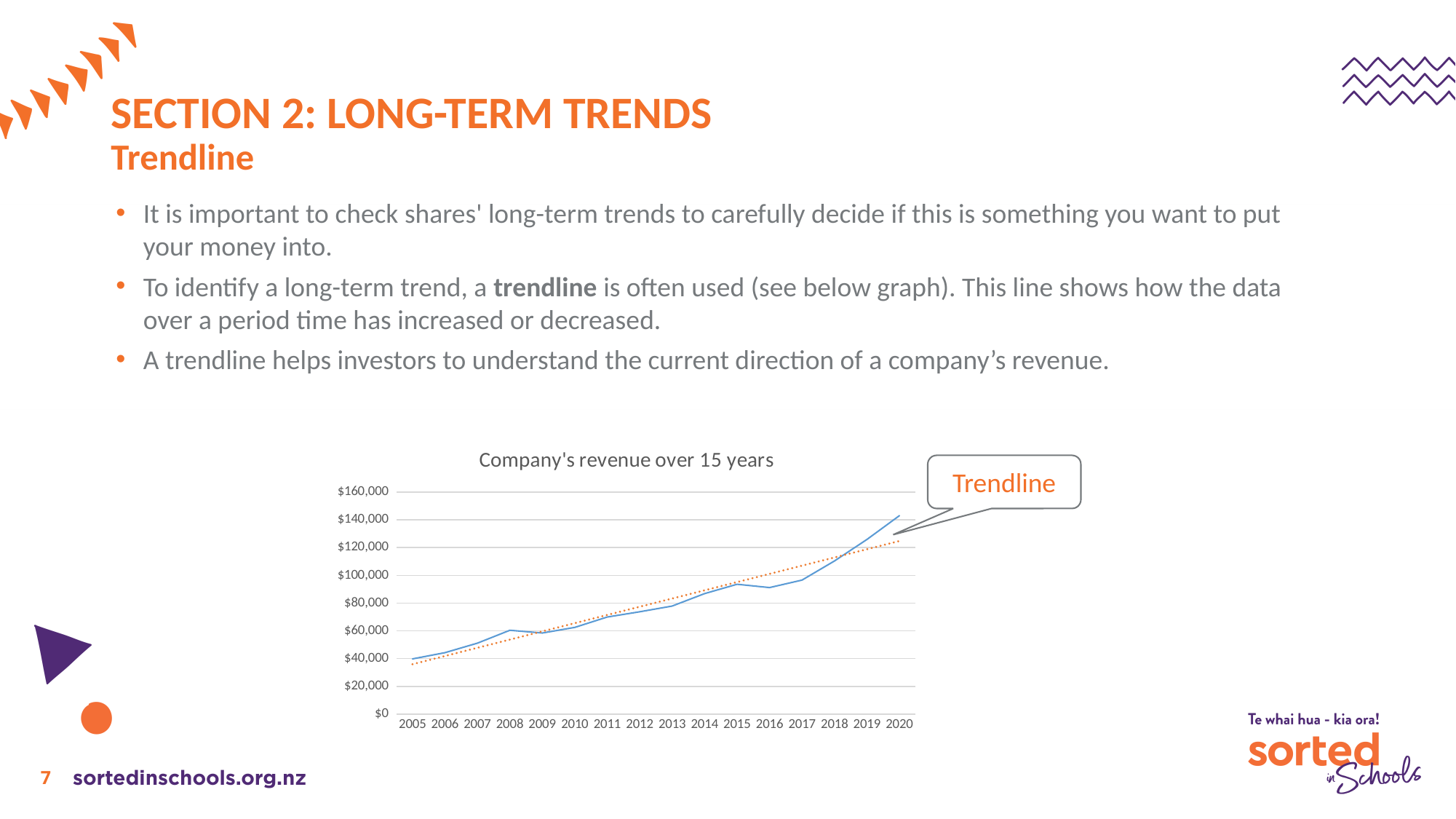
What kind of chart is shown on the slide? line chart Which year has the lowest revenue on the chart? 2005 What does the callout label on the chart identify the dotted orange line as? Trendline Which year has the larger revenue, 2010 or 2014? 2014 Is the revenue for 2015 greater or less than $100,000? less Is the revenue for 2005 greater or less than $60,000? less Is the revenue for 2013 greater or less than $60,000? greater Which year has the highest revenue on the chart? 2020 How many years are plotted along the x axis of the chart? 16 Does the company's revenue generally rise or fall from 2005 to 2020? rise What is the title of the chart? Company's revenue over 15 years